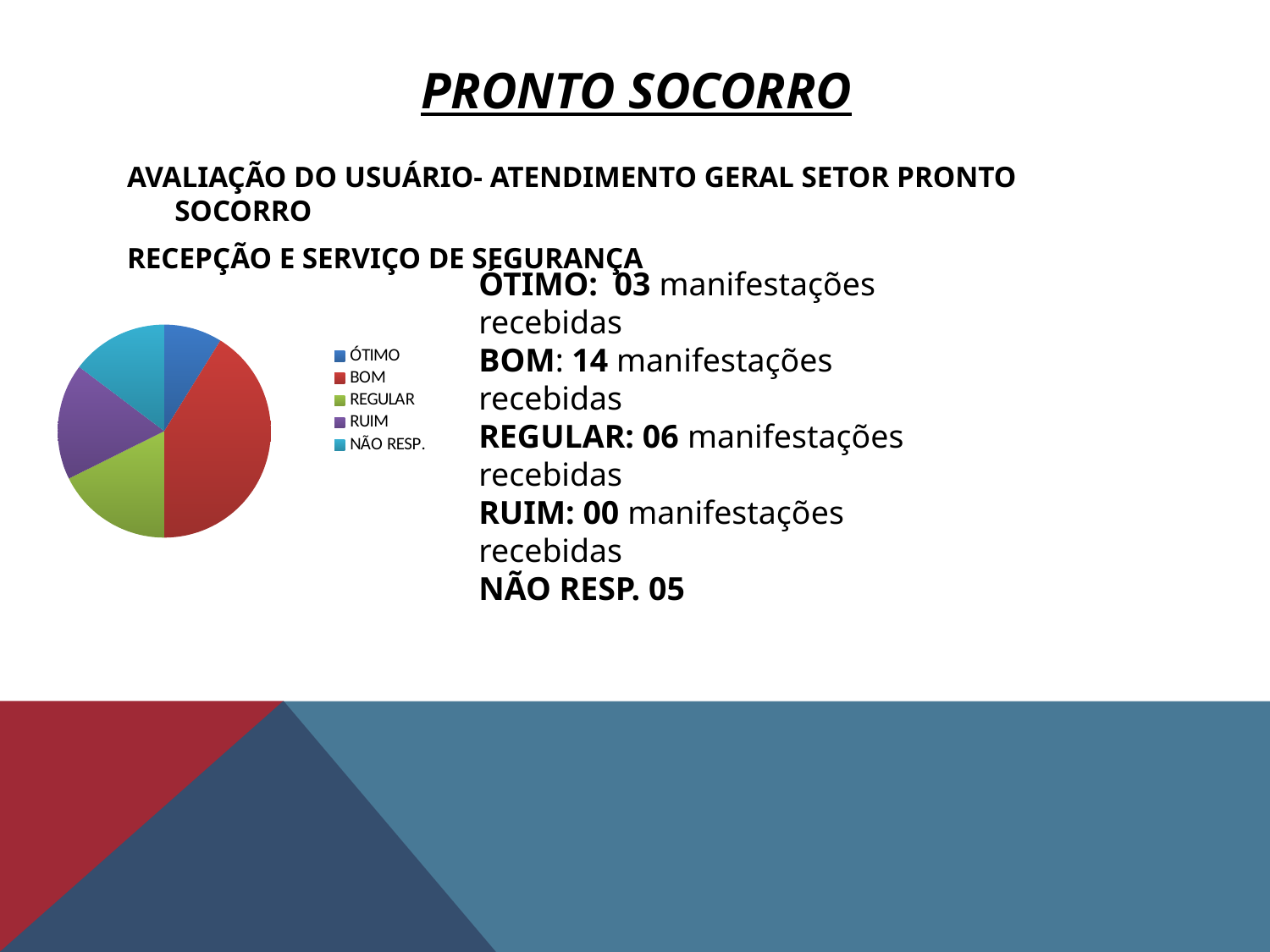
Which category has the largest slice in the pie chart? BOM How many categories does the pie chart's legend list? 5 How many manifestações recebidas are reported for BOM? 14 How many manifestações recebidas are reported for ÓTIMO? 03 How many manifestações recebidas are reported for REGULAR? 06 Which colour represents BOM in the pie chart? red Which is larger, the value for BOM or the value for ÓTIMO? BOM Which legend entry is listed last in the pie chart's legend? NÃO RESP. What kind of chart is shown on the slide? pie chart What is the difference between the values for BOM and REGULAR? 8 How many manifestações are reported for NÃO RESP.? 05